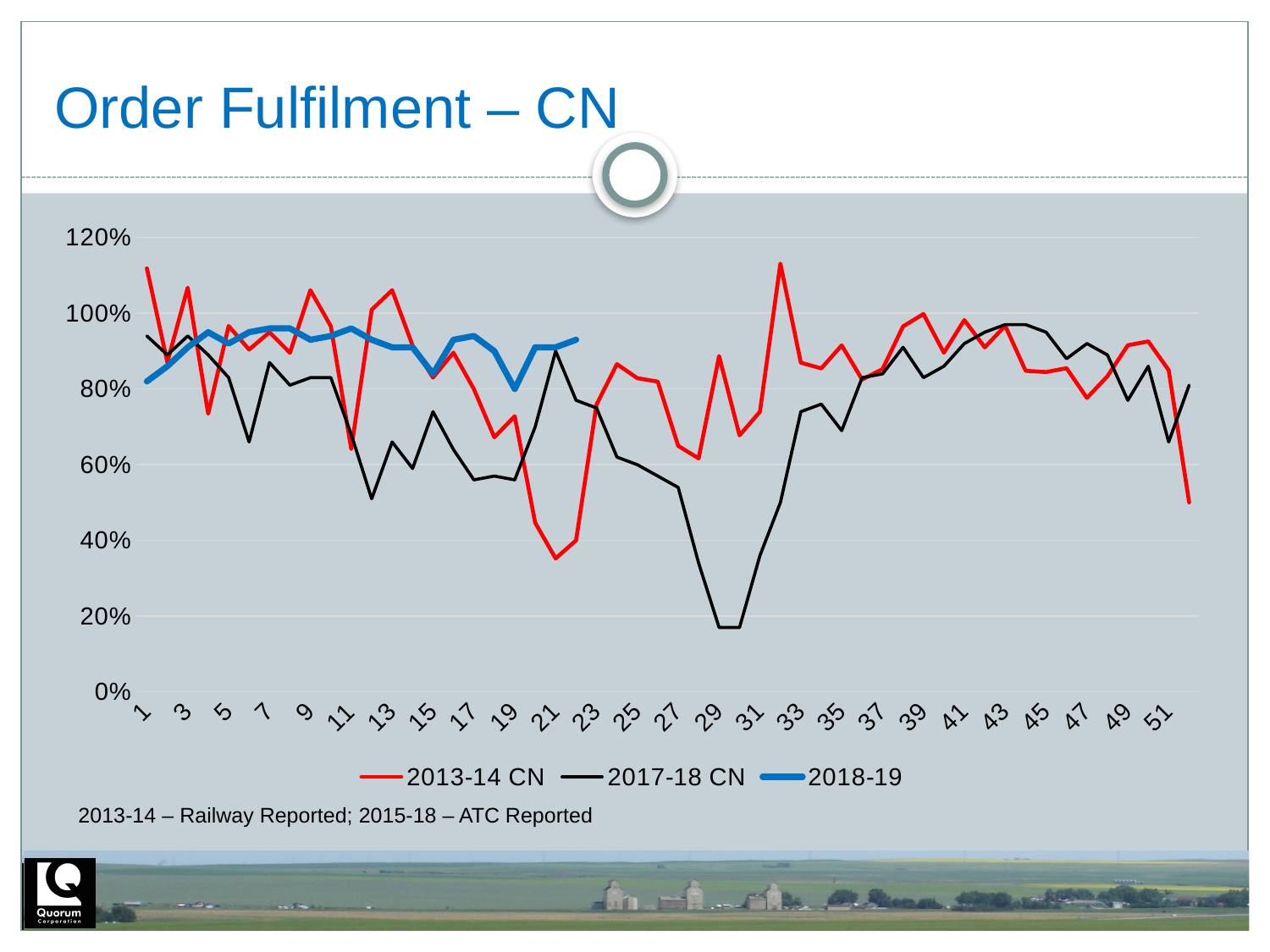
Which series reaches the lowest value anywhere on the chart? 2017-18 CN Is the value for 2013-14 CN at week 21 greater or less than 40%? less What is the highest value shown on the y axis? 120% At week 21, which series has the larger value, 2013-14 CN or 2017-18 CN? 2017-18 CN Is the value for 2017-18 CN at week 29 greater or less than 20%? less How many series does the legend list? 3 Is the value for 2013-14 CN at week 52 greater or less than 60%? less At week 29, which series has the larger value, 2013-14 CN or 2017-18 CN? 2013-14 CN What kind of chart is shown on the slide? line chart Which series is drawn in blue? 2018-19